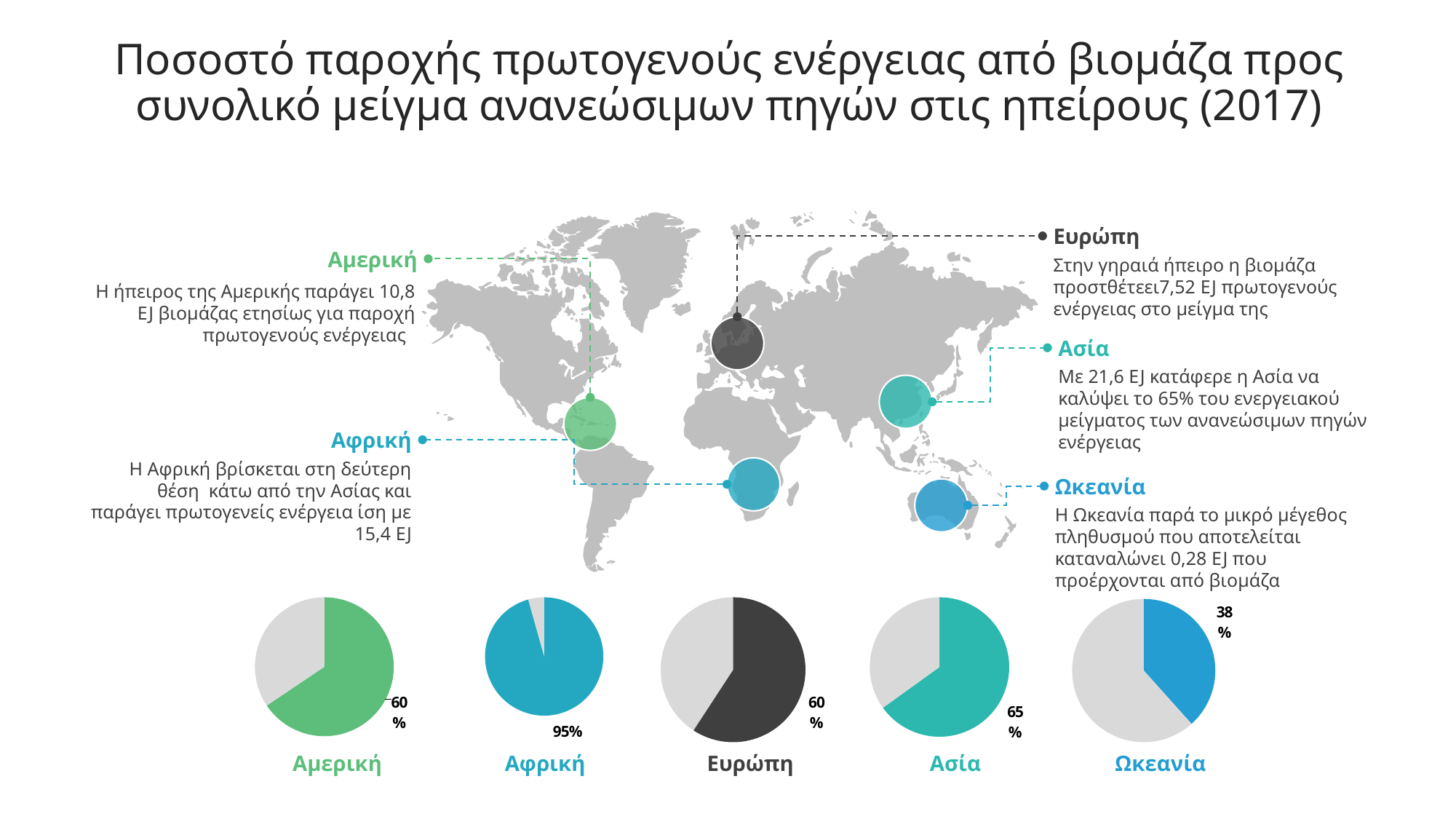
In the Ασία pie chart, what percentage is shown for the teal slice? 65% What is the difference between the labelled percentage in the Αφρική pie chart and the Ωκεανία pie chart? 57% What kind of charts are shown at the bottom of the slide? Pie charts In the Αφρική pie chart, what percentage is shown for the blue slice? 95% In the Ωκεανία pie chart, what percentage is shown for the blue slice? 38% In the Αμερική pie chart, what percentage is shown for the green slice? 60% What colour is the labelled slice in the Ευρώπη pie chart? Dark grey Across the five pie charts, which continent has the lowest labelled percentage? Ωκεανία Across the five pie charts, which continent has the highest labelled percentage? Αφρική Which is larger: the labelled percentage in the Ασία pie chart or the Αμερική pie chart? Ασία How many pie charts are shown on the slide? 5 In the Ευρώπη pie chart, what percentage is shown for the dark slice? 60%